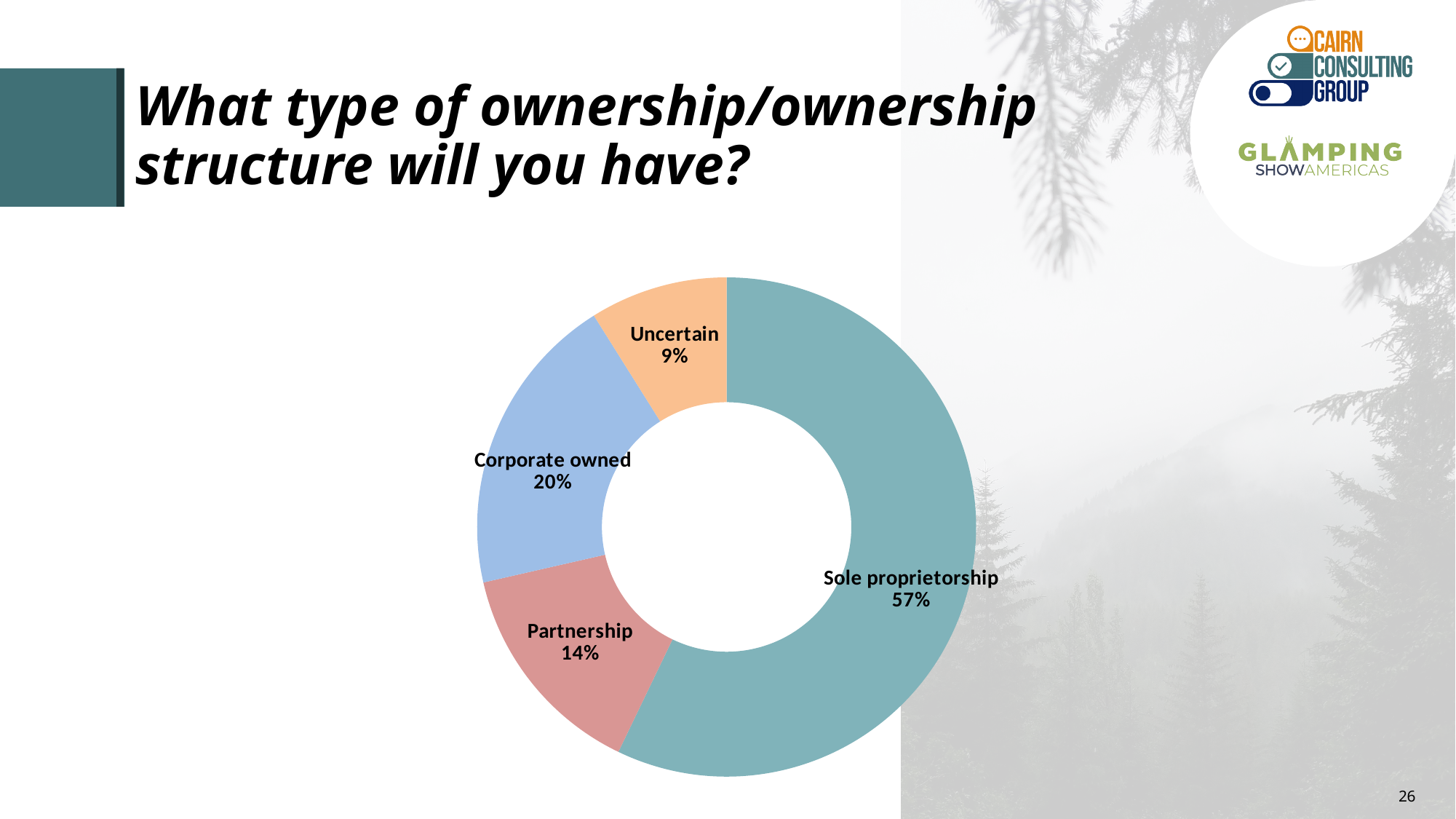
What percentage of respondents chose Partnership? 14% Which is larger, Partnership or Uncertain? Partnership What percentage of respondents chose Sole proprietorship? 57% What is the difference in percentage points between Sole proprietorship and Corporate owned? 37 Which ownership structure has the largest share? Sole proprietorship What is the difference in percentage points between Corporate owned and Partnership? 6 What colour is the Partnership segment? Red Which category has the smallest share? Uncertain What percentage of respondents were Uncertain? 9% What kind of chart is shown on the slide? Doughnut chart How many categories are shown in the chart? 4 What percentage of respondents chose Corporate owned? 20%